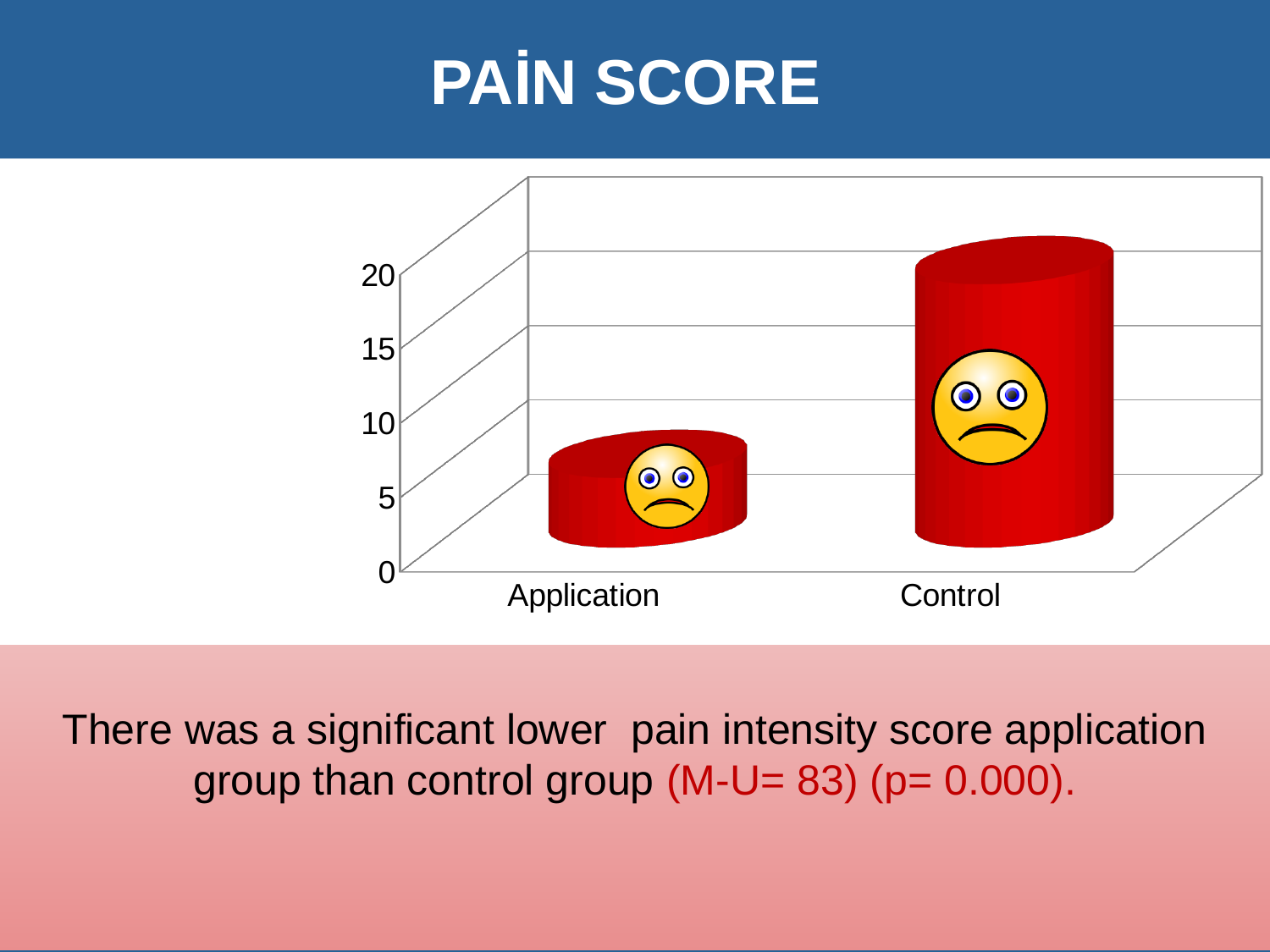
What is the title of the slide containing the chart? PAİN SCORE How many categories are shown on the x axis of the chart? 2 Is the value for Control greater or less than 15? greater Which is larger, the pain score for Application or for Control? Control Which group has the highest pain score in the chart? Control Do the values rise or fall moving from Application to Control along the x axis? rise What colour are the bars in the chart? red Is the value for Application greater or less than 15? less Which group has the lowest pain score in the chart? Application Is the value for Application greater or less than 10? less What kind of chart is shown on the slide? bar chart